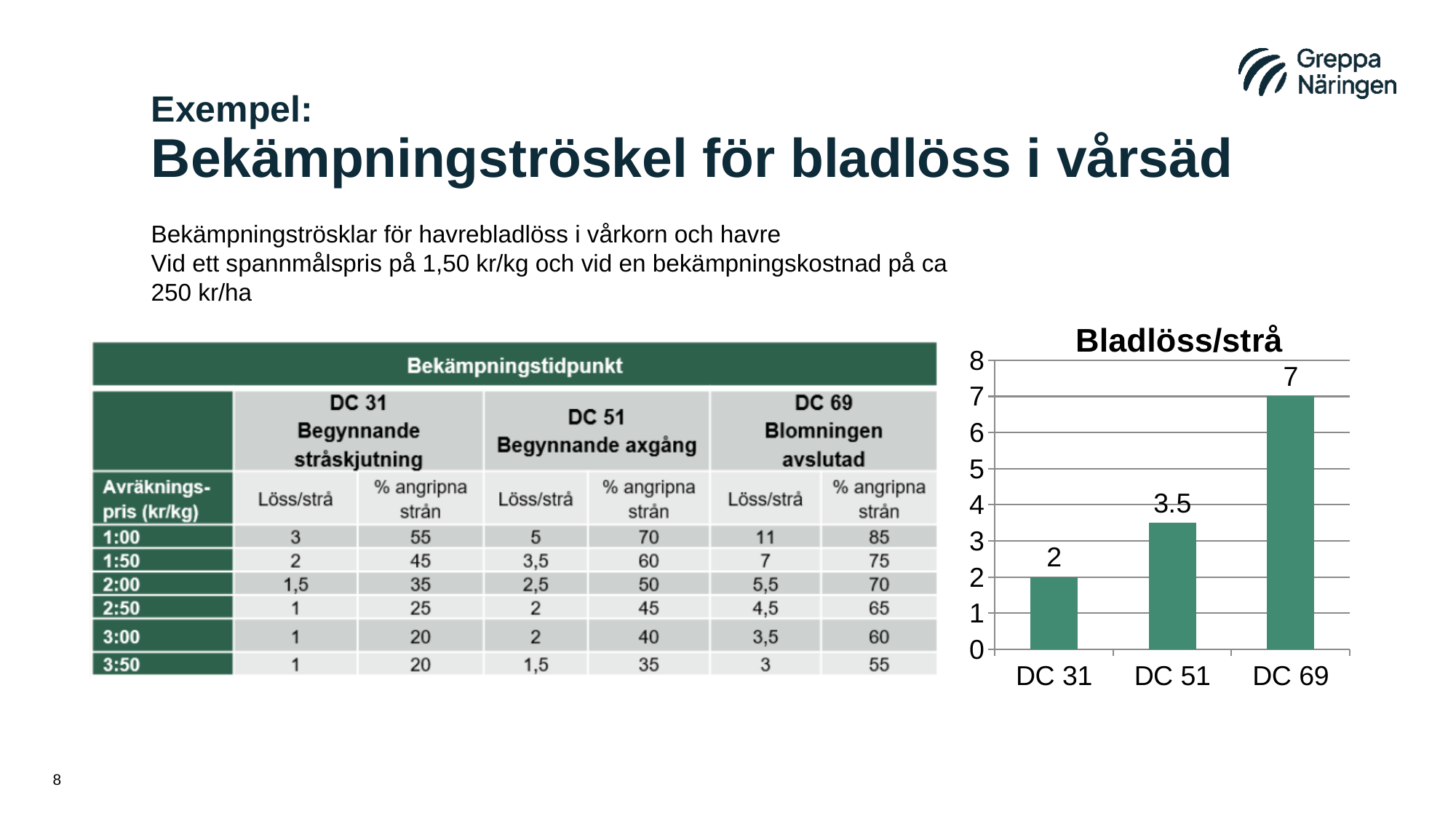
Which category has the lowest value in the Bladlöss/strå chart? DC 31 What is the difference between the values for DC 51 and DC 31 in the Bladlöss/strå chart? 1.5 What is the difference between the values for DC 69 and DC 31 in the Bladlöss/strå chart? 5 Which is larger in the Bladlöss/strå chart, the value for DC 51 or DC 69? DC 69 What is the value for DC 51 in the Bladlöss/strå chart? 3.5 How many categories are shown in the Bladlöss/strå chart? 3 What is the value for DC 69 in the Bladlöss/strå chart? 7 What kind of chart is the Bladlöss/strå chart? bar chart Which category has the highest value in the Bladlöss/strå chart? DC 69 What is the value for DC 31 in the Bladlöss/strå chart? 2 Is the value for DC 51 in the Bladlöss/strå chart greater or less than 4? less Do the values in the Bladlöss/strå chart rise or fall from DC 31 to DC 69? rise